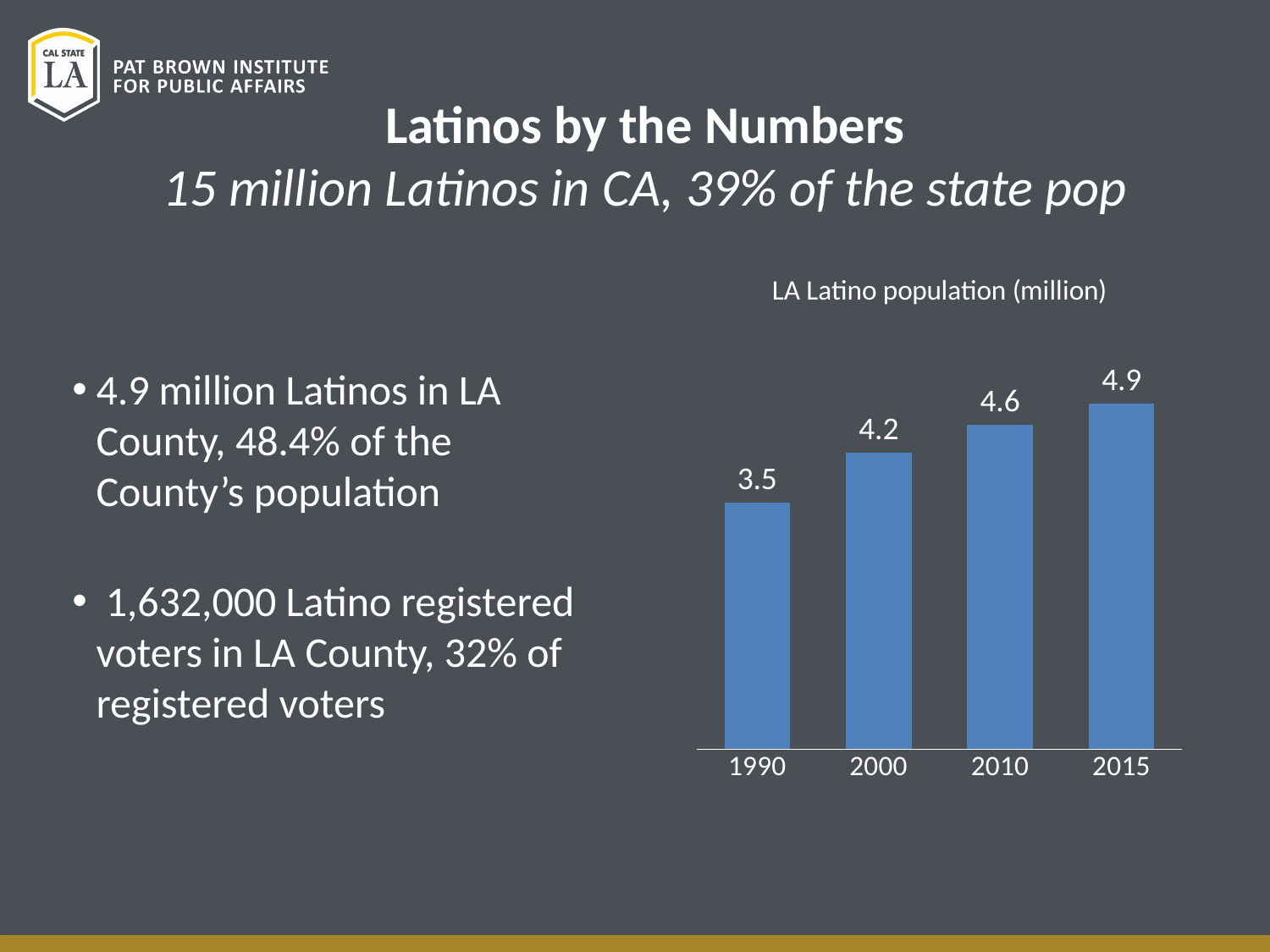
What kind of chart is used to show the LA Latino population? Bar chart What is the LA Latino population (million) shown for 1990? 3.5 Which year has the lowest LA Latino population in the chart? 1990 What is the LA Latino population (million) shown for 2015? 4.9 Which year has the highest LA Latino population in the chart? 2015 What is the difference between the LA Latino population in 2010 and in 2000? 0.4 What is the LA Latino population (million) shown for 2010? 4.6 Does the LA Latino population rise or fall from 1990 to 2015? Rise How many years are shown on the x axis of the chart? 4 Which year has a larger LA Latino population, 2000 or 2010? 2010 What is the LA Latino population (million) shown for 2000? 4.2 What is the difference between the LA Latino population in 2015 and in 1990? 1.4